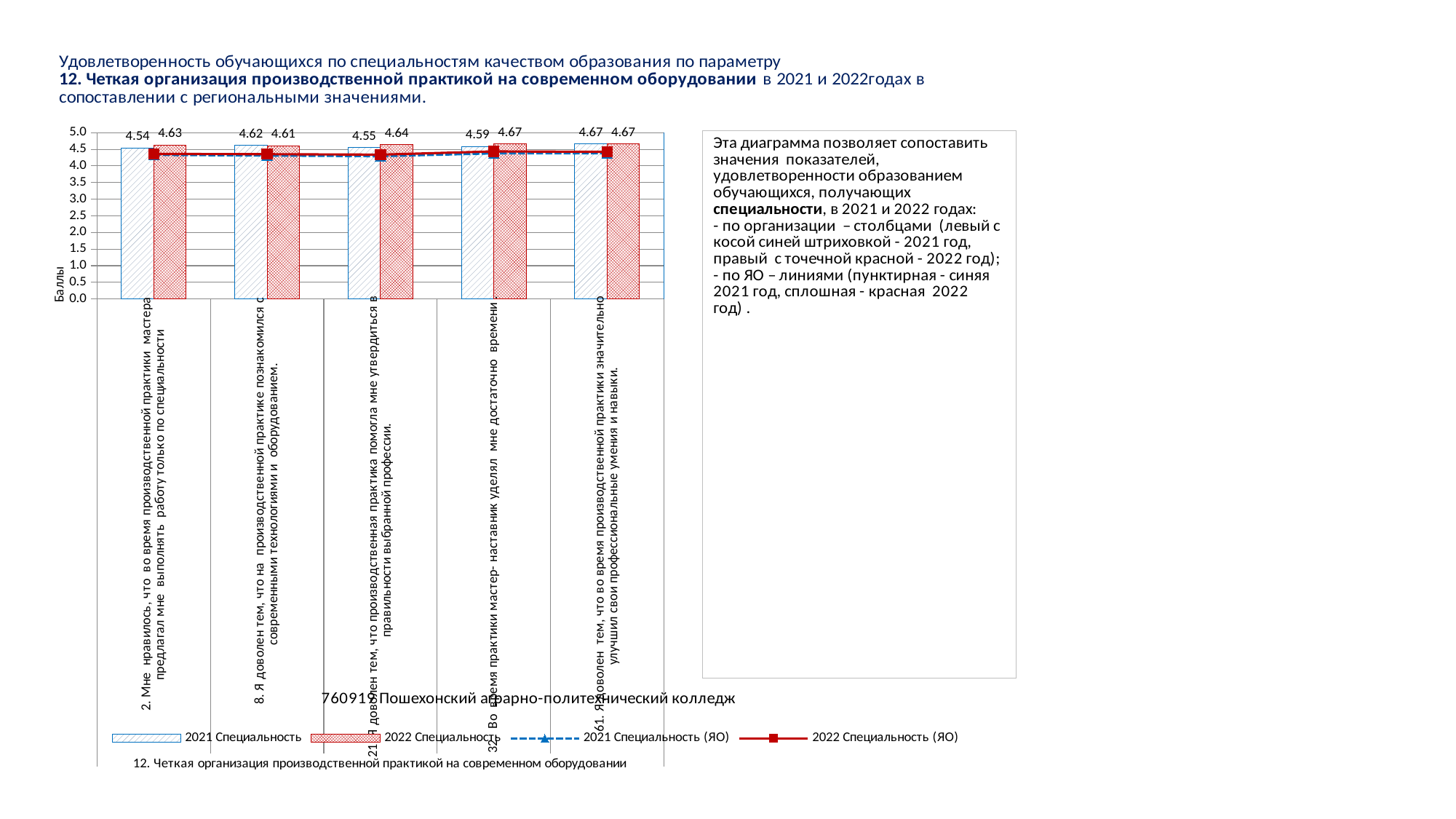
Which statement has the lowest 2022 Специальность value? 8. Я доволен тем, что на производственной практике познакомился с современными технологиями и оборудованием What is the value of the 2022 Специальность bar for statement 32 (мастер-наставник уделял мне достаточно времени)? 4.67 What is the label of the vertical axis of the chart? Баллы Which statement has the lowest 2021 Специальность value? 2. Мне нравилось, что во время производственной практики мастер предлагал мне выполнять работу только по специальности Is the 2021 Специальность (ЯО) line value for statement 2 greater or less than 4.0? greater What is the difference between the 2022 and 2021 Специальность values for statement 2? 0.09 What is the value of the 2021 Специальность bar for statement 2 (Мне нравилось, что во время производственной практики мастер предлагал мне выполнять работу только по специальности)? 4.54 What is the value of the 2022 Специальность bar for statement 21 (производственная практика помогла мне утвердиться в правильности выбранной профессии)? 4.64 How many series does the chart legend list? 4 For statement 8, which is larger: the 2021 Специальность value or the 2022 Специальность value? 2021 Специальность (4.62) How many statements (categories) are shown on the x axis of the chart? 5 Which statement has the highest 2021 Специальность value? 61. Я доволен тем, что во время производственной практики значительно улучшил свои профессиональные умения и навыки